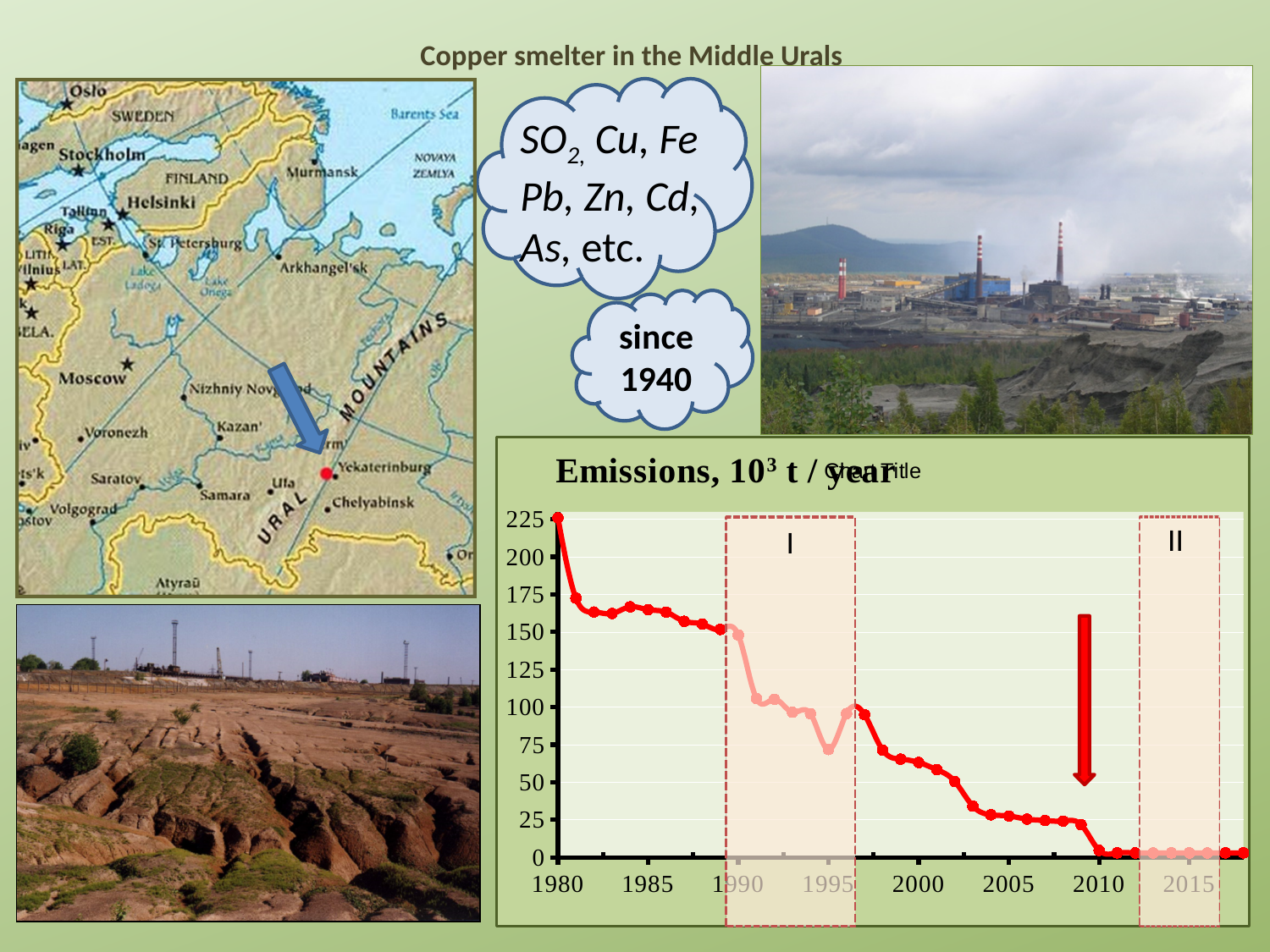
Is the emissions value for 1980 greater or less than 200? greater What labels mark the two shaded periods on the chart? I and II What is the title of the chart? Emissions, 10³ t / year In which year shown on the x axis are emissions highest? 1980 Is the emissions value for 2005 greater or less than 50? less Do the emission values generally rise or fall from 1980 to 2015? fall Is the emissions value for 1985 greater or less than 150? greater Which year has lower emissions, 1995 or 2010? 2010 Which year has higher emissions, 1985 or 2005? 1985 What kind of chart is shown on the slide? line chart